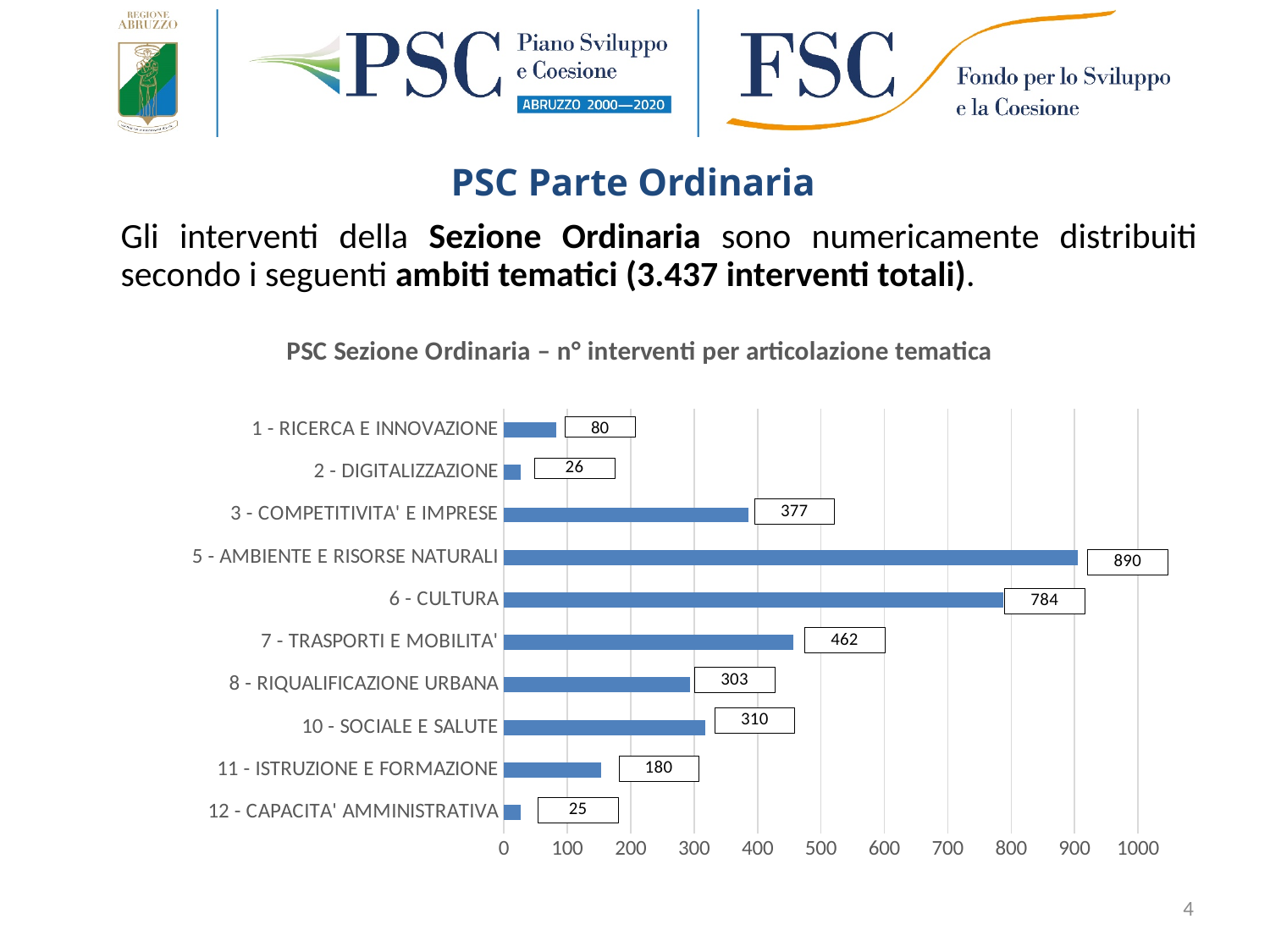
What kind of chart is shown on the slide? bar chart What is the difference between the values for 1 - RICERCA E INNOVAZIONE and 12 - CAPACITA' AMMINISTRATIVA? 55 What is the title of the chart? PSC Sezione Ordinaria – n° interventi per articolazione tematica Which category has the lowest value? 12 - CAPACITA' AMMINISTRATIVA Is the value for 11 - ISTRUZIONE E FORMAZIONE greater or less than 200? less Which is larger, the value for 8 - RIQUALIFICAZIONE URBANA or 10 - SOCIALE E SALUTE? 10 - SOCIALE E SALUTE What is the value for 2 - DIGITALIZZAZIONE? 26 What is the value for 7 - TRASPORTI E MOBILITA'? 462 What is the difference between the values for 6 - CULTURA and 3 - COMPETITIVITA' E IMPRESE? 407 Which category has the highest value? 5 - AMBIENTE E RISORSE NATURALI What is the value for 5 - AMBIENTE E RISORSE NATURALI? 890 How many categories are shown in the chart? 10